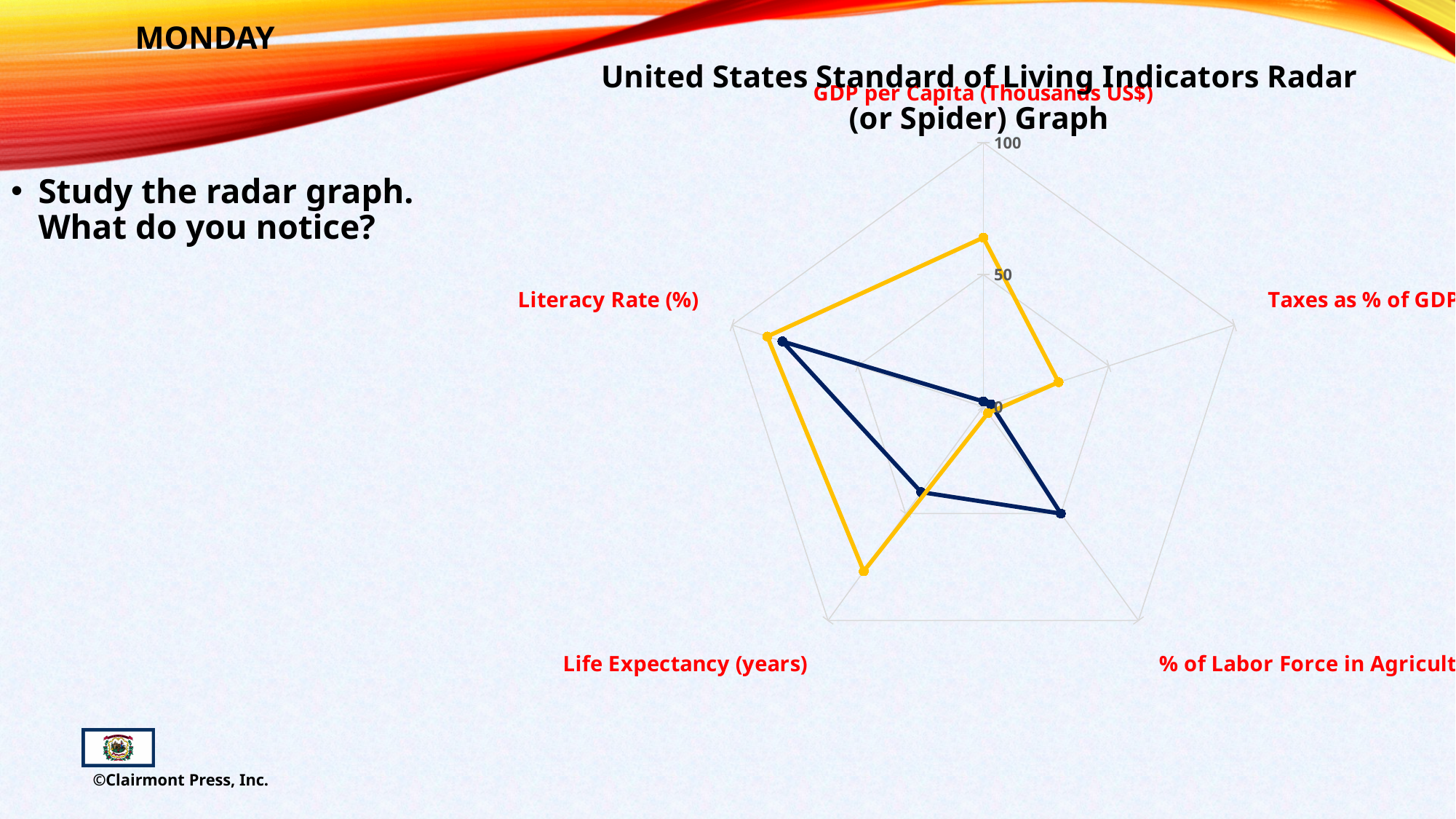
How many indicator axes (categories) does the radar chart have? 5 Which series has the larger value for % of Labor Force in Agriculture, the yellow series or the dark blue series? Dark blue series What kind of chart is shown on the slide? Radar chart Is the yellow series' value for Taxes as % of GDP greater or less than 50? less What is the title of the chart? United States Standard of Living Indicators Radar (or Spider) Graph On which indicator does the yellow series reach its highest value? Literacy Rate (%) How many data series (lines) are plotted on the radar chart? 2 Is the dark blue series' value for GDP per Capita (Thousands US$) greater or less than 50? less Which series has the larger value for Life Expectancy (years), the yellow series or the dark blue series? Yellow series Is the yellow series' value for Life Expectancy (years) greater or less than 50? greater What is the highest value marked on the radar chart's axis scale? 100